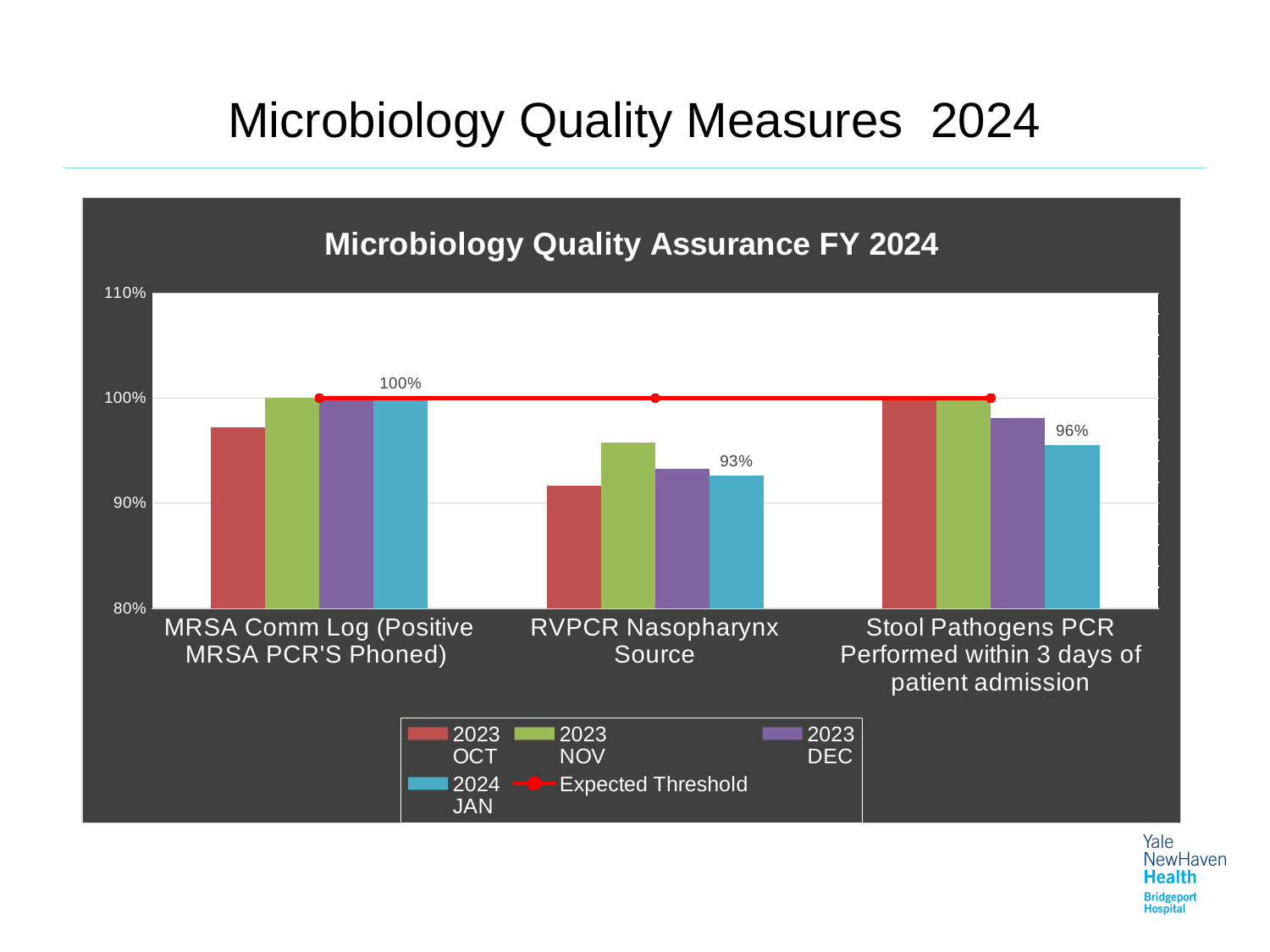
How many entries does the legend list? 5 Is the 2024 JAN value for Stool Pathogens PCR larger or smaller than the 2024 JAN value for RVPCR Nasopharynx Source? larger Is the 2023 OCT value for MRSA Comm Log greater or less than 90%? greater How many categories are shown on the x axis? 3 What is the 2024 JAN value for Stool Pathogens PCR Performed within 3 days of patient admission? 96% What is the title of the chart? Microbiology Quality Assurance FY 2024 What is the 2024 JAN value for MRSA Comm Log (Positive MRSA PCR'S Phoned)? 100% Is the 2023 OCT value for RVPCR Nasopharynx Source greater or less than 100%? less What is the difference between the 2024 JAN values for MRSA Comm Log and RVPCR Nasopharynx Source? 7 percentage points What is the 2024 JAN value for RVPCR Nasopharynx Source? 93% Which category has the lowest 2024 JAN value? RVPCR Nasopharynx Source Which category has the highest 2024 JAN value? MRSA Comm Log (Positive MRSA PCR'S Phoned)